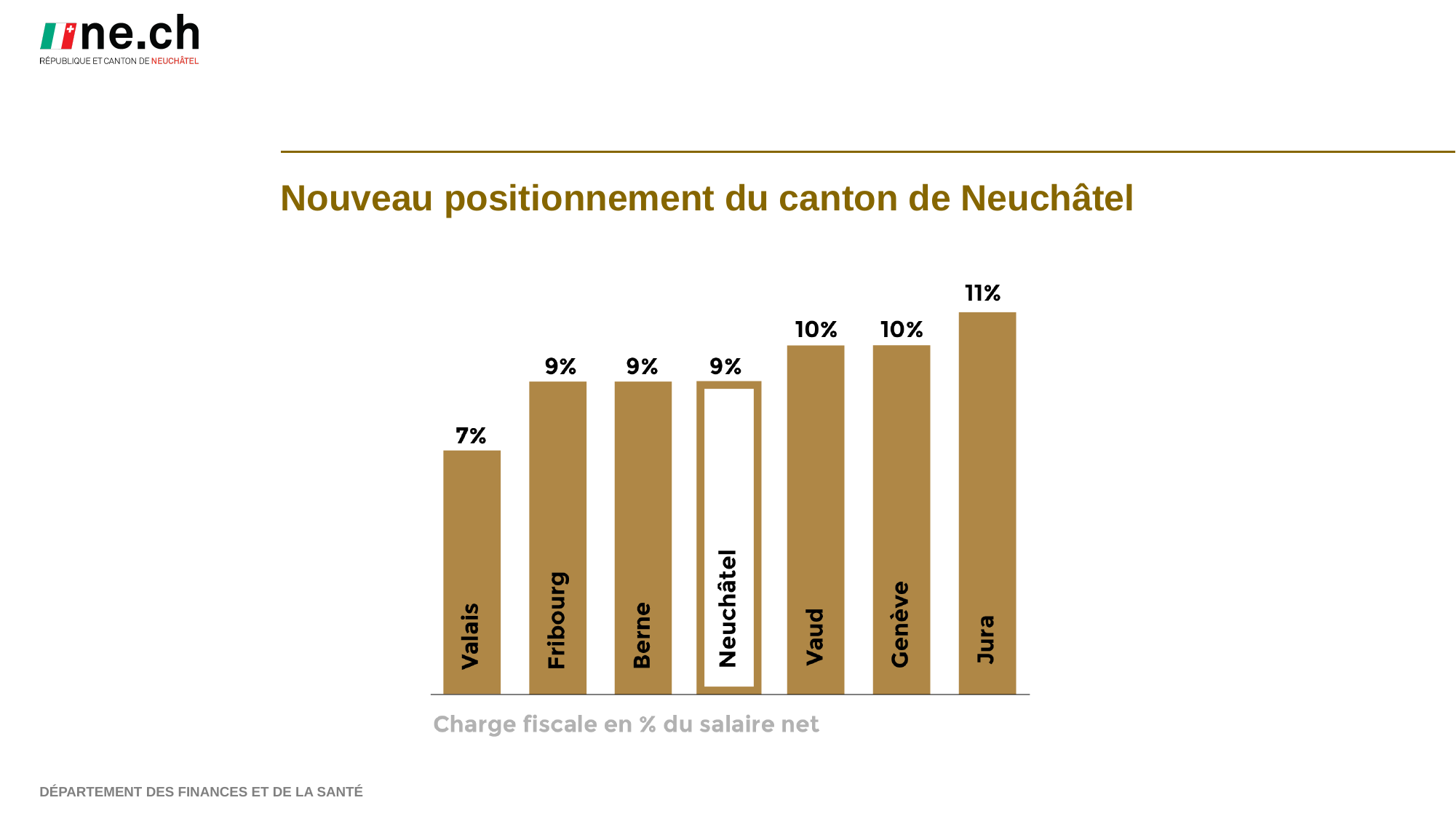
Do the values generally rise or fall from left to right along the x axis? Rise How many cantons are shown in the chart? 7 What is the value for Vaud? 10% Which canton has the highest value? Jura Which is larger, the value for Genève or the value for Berne? Genève What is the difference between the values for Jura and Valais? 4% What is the value for Neuchâtel? 9% Which canton has the lowest value? Valais What is the value for Valais? 7% What is the caption below the chart's x axis? Charge fiscale en % du salaire net What kind of chart is shown on the slide? Bar chart What is the value for Jura? 11%